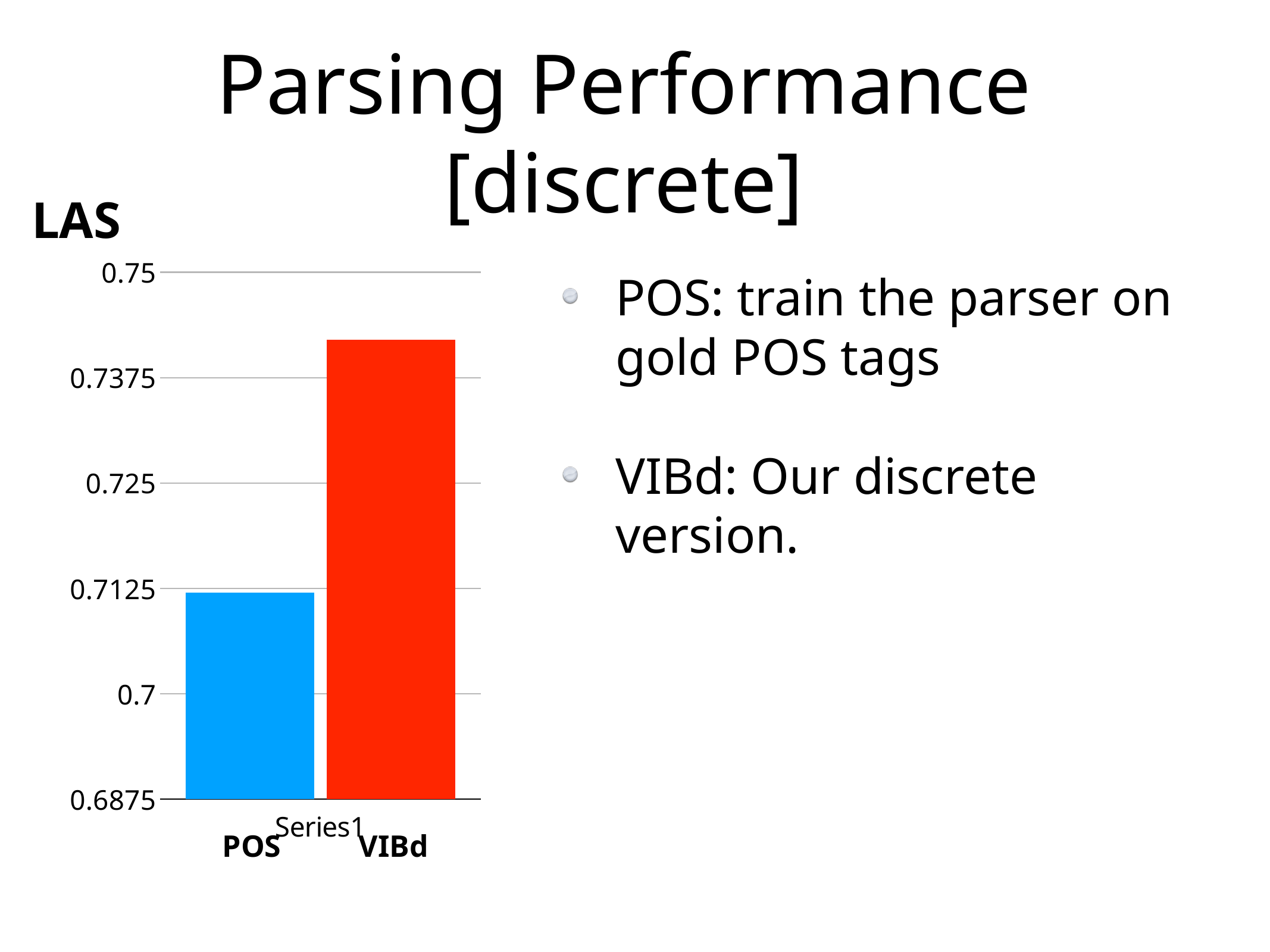
Is the value for VIBd greater or less than 0.75? less What kind of chart is shown on the slide? bar chart Which has a larger LAS value, POS or VIBd? VIBd Is the value for POS greater or less than 0.7? greater How many bars are plotted in the chart? 2 Is the value for POS greater or less than 0.725? less Do the bar values rise or fall going from POS to VIBd along the x axis? rise What label is shown on the vertical axis of the chart? LAS What colour is the bar for VIBd? red Which category has the highest LAS value in the chart? VIBd Which category has the lowest LAS value in the chart? POS